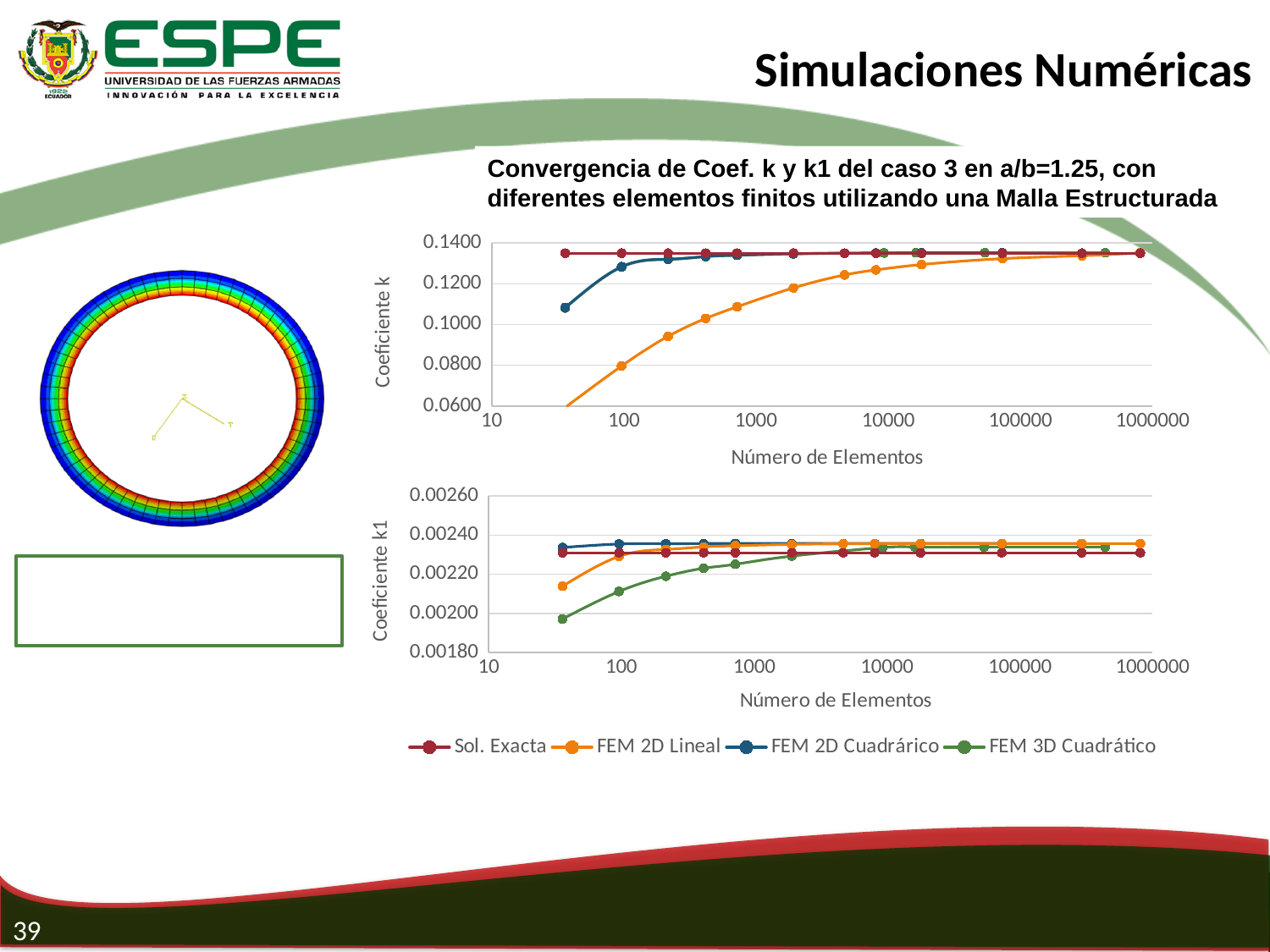
What is the label of the x axis on the bottom chart (Coeficiente k1)? Número de Elementos In the top chart (Coeficiente k), is the value of FEM 2D Lineal at 100 elements greater or less than 0.1000? less In the top chart (Coeficiente k), is the leftmost value of FEM 2D Cuadrárico greater or less than 0.1000? greater In the top chart (Coeficiente k), does the FEM 2D Lineal series rise or fall as the number of elements increases? rise How many series does the legend list? 4 Which series is drawn in orange in the legend? FEM 2D Lineal In the top chart (Coeficiente k), at the leftmost data point, which is larger: FEM 2D Cuadrárico or FEM 2D Lineal? FEM 2D Cuadrárico In the bottom chart (Coeficiente k1), at the leftmost data point, which is larger: FEM 2D Lineal or FEM 3D Cuadrático? FEM 2D Lineal What kind of chart is the top chart (Coeficiente k)? line chart In the bottom chart (Coeficiente k1), does the FEM 3D Cuadrático series rise or fall as the number of elements increases? rise In the bottom chart (Coeficiente k1), is the leftmost value of FEM 2D Lineal greater or less than 0.00220? less